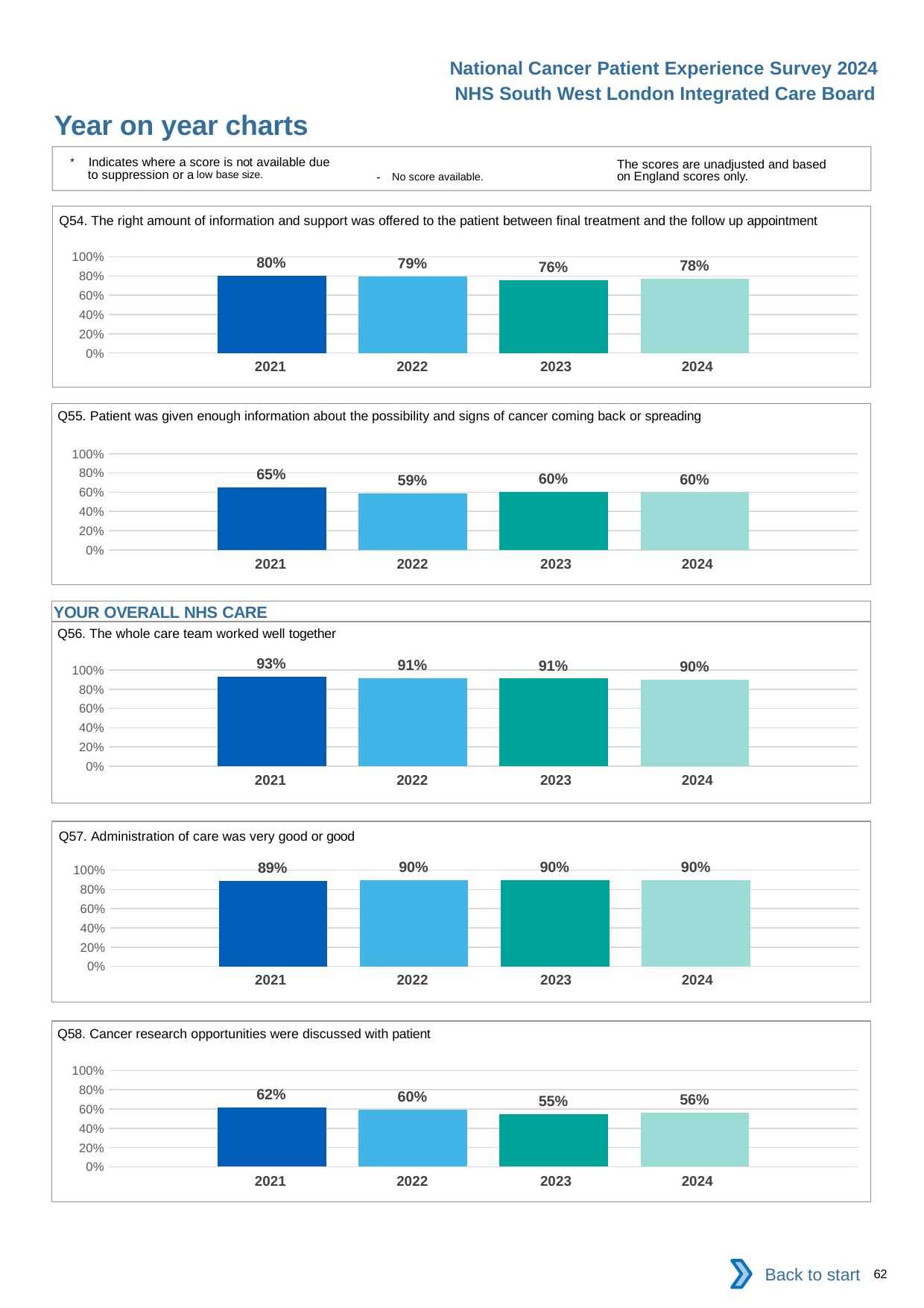
In the Q55 chart, which year has the highest value? 2021 What kind of chart is the Q58 chart? Bar chart In the Q57 chart, how many years are shown on the x axis? 4 In the Q58 chart, what is the difference between the 2021 and 2024 values? 6% In the Q57 chart, what is the value for 2021? 89% In the Q54 chart, what is the value for 2021? 80% In the Q54 chart, which year has the lowest value? 2023 In the Q55 chart, what is the difference between the 2021 and 2022 values? 6% What is the section heading shown above the Q56 chart? YOUR OVERALL NHS CARE In the Q58 chart, which year has the lowest value? 2023 In the Q56 chart, is the value for 2021 larger than the value for 2024? Yes In the Q56 chart, what is the value for 2024? 90%